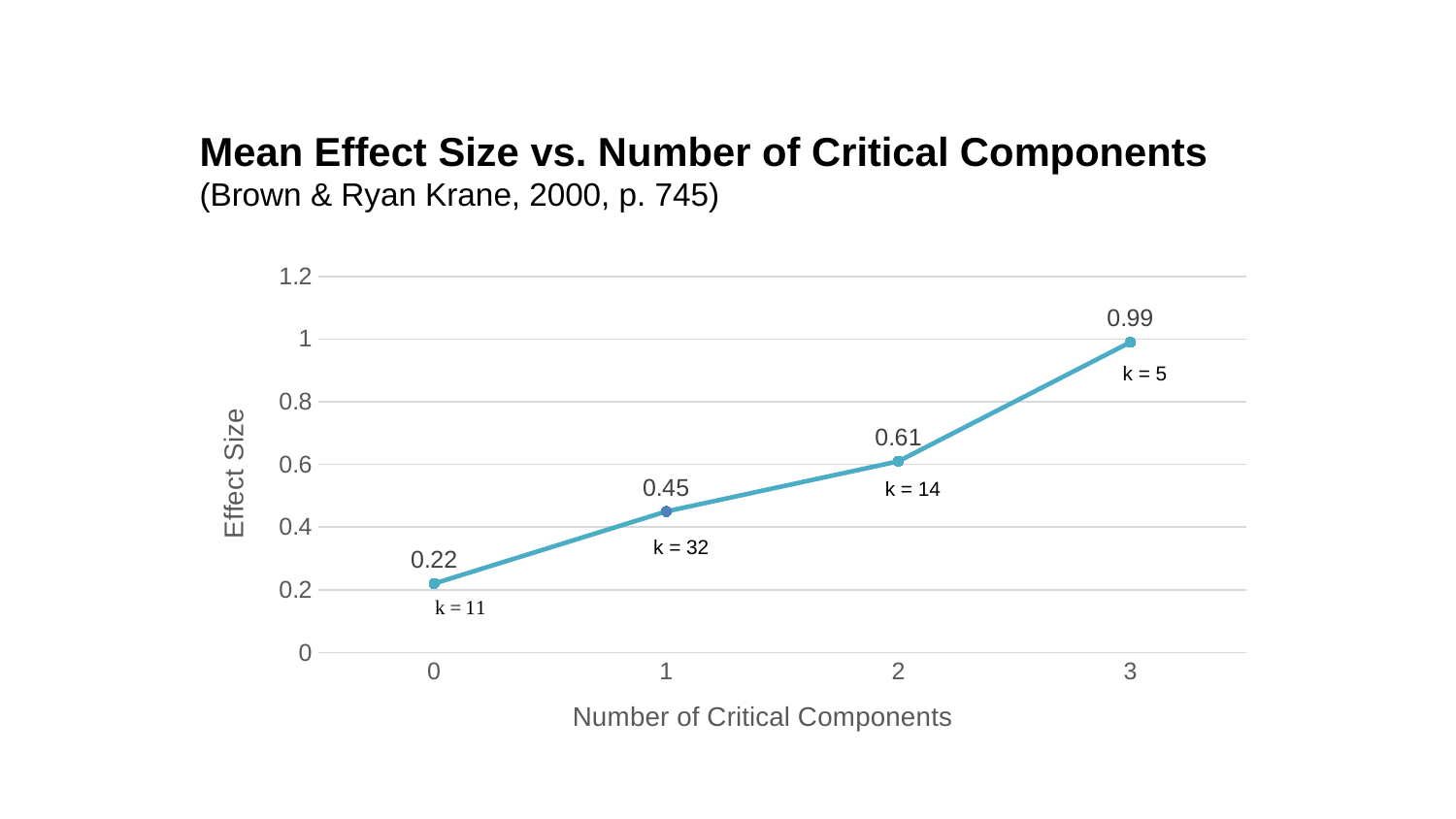
What is the effect size at 2 critical components? 0.61 Which has a larger effect size: 1 critical component or 2 critical components? 2 critical components What is the label of the y-axis? Effect Size Does the effect size rise or fall as the number of critical components increases? Rises Which number of critical components has the lowest effect size? 0 Which number of critical components has the highest effect size? 3 What is the difference in effect size between 3 and 0 critical components? 0.77 What is the effect size when the number of critical components is 3? 0.99 What type of chart is shown? Line chart How many data points are plotted on the chart? 4 What is the effect size when the number of critical components is 0? 0.22 What is the difference in effect size between 2 and 1 critical components? 0.16